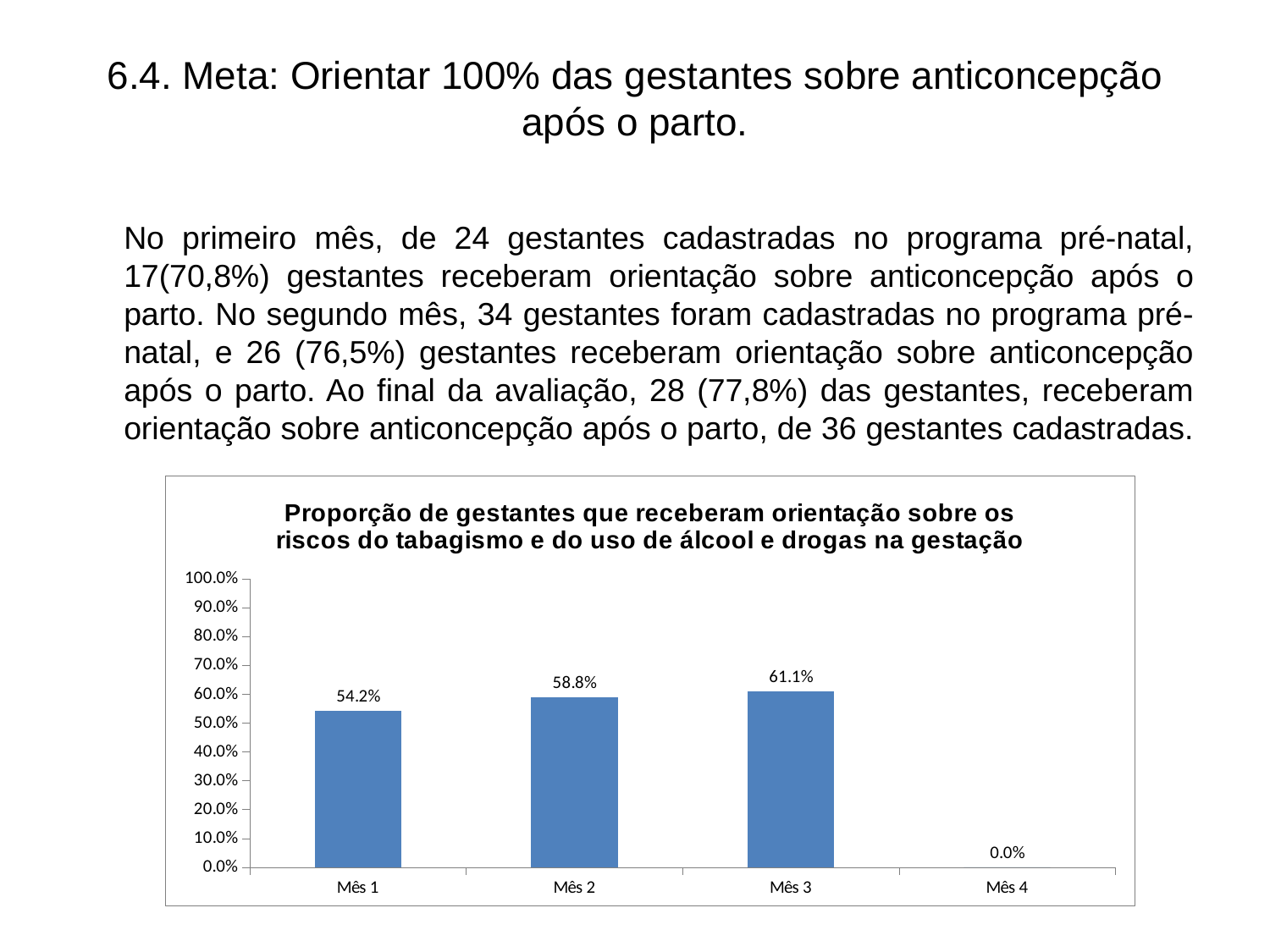
What kind of chart is shown? Bar chart What is the value for Mês 1? 54.2% Which month has the lowest value? Mês 4 What is the value for Mês 2? 58.8% Which is larger, the value for Mês 2 or the value for Mês 1? Mês 2 Which month has the highest value? Mês 3 What is the difference between the values for Mês 3 and Mês 1? 6.9% Is the value for Mês 3 greater or less than 50.0%? greater How many months are shown on the x axis? 4 What is the title of the chart? Proporção de gestantes que receberam orientação sobre os riscos do tabagismo e do uso de álcool e drogas na gestação What is the value for Mês 4? 0.0% What is the value for Mês 3? 61.1%